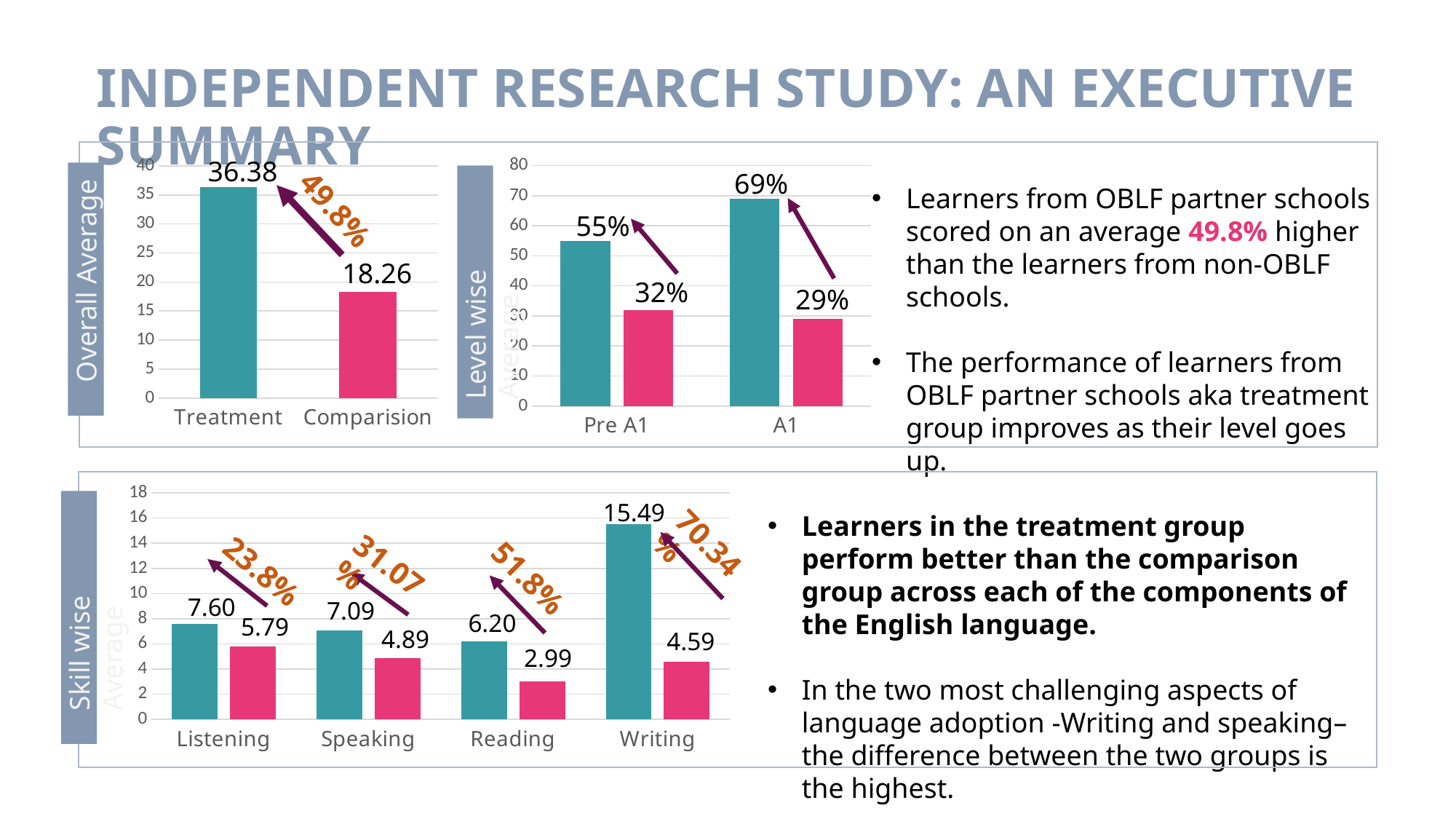
In the Level wise Average chart, what is the value of the teal bar for A1? 69% In the Skill wise Average chart, what is the value of the teal bar for Writing? 15.49 In the Overall Average chart, what is the difference between the Treatment and Comparision values? 18.12 In the Overall Average chart, what is the value for Comparision? 18.26 In the Level wise Average chart, which is larger: the pink bar for Pre A1 or the pink bar for A1? Pre A1 What type of chart is the Skill wise Average chart? Bar chart In the Skill wise Average chart, which skill has the lowest pink bar? Reading In the Skill wise Average chart, what is the value of the pink bar for Reading? 2.99 In the Level wise Average chart, what is the value of the pink bar for Pre A1? 32% In the Level wise Average chart, how many categories are shown on the x axis? 2 In the Overall Average chart, what is the value for Treatment? 36.38 In the Skill wise Average chart, which skill has the highest teal bar? Writing